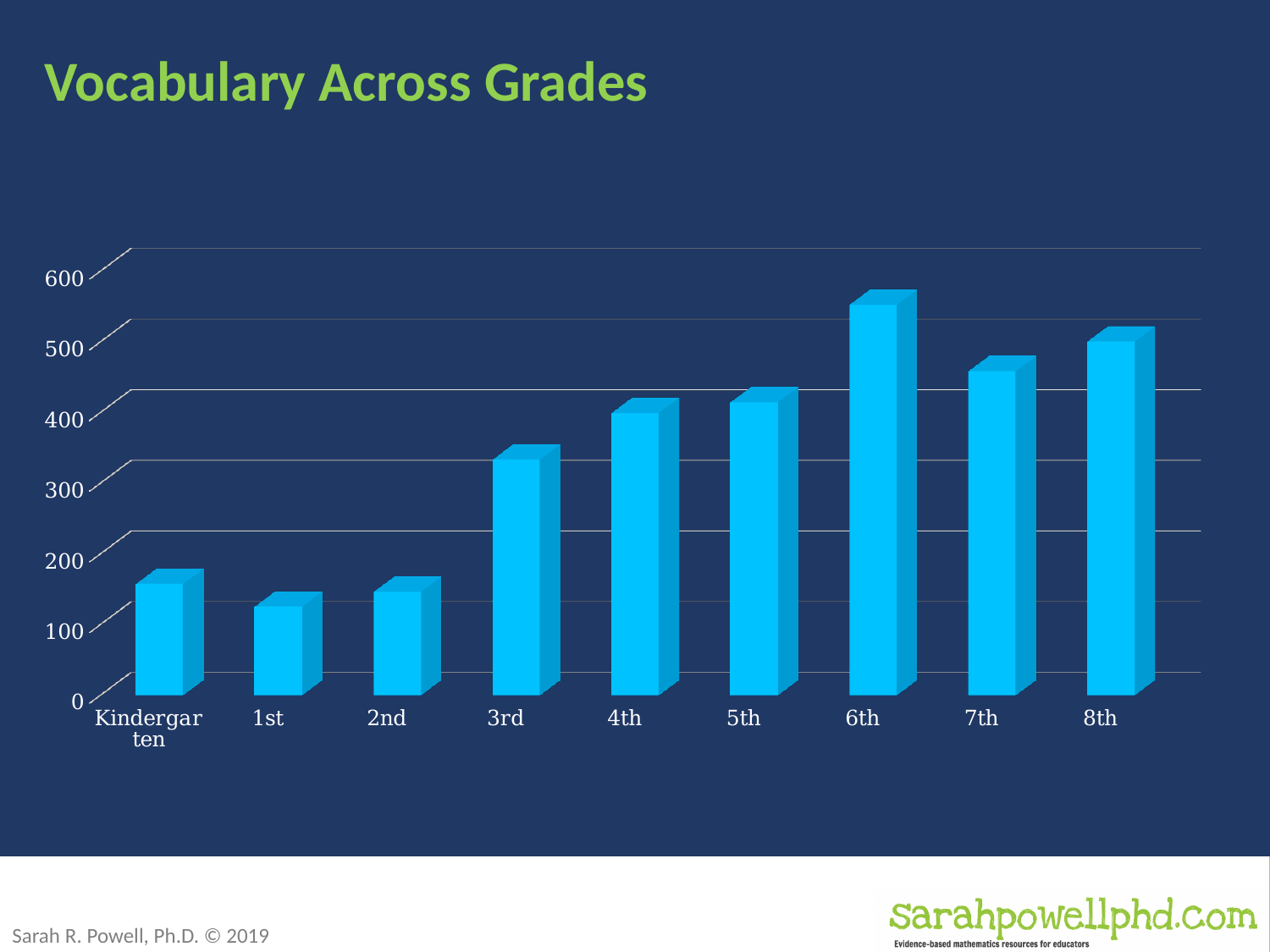
Is the value for 1st grade greater or less than 200? less How many grade categories are plotted on the chart? 9 Is the value for 3rd grade greater or less than 300? greater Which grade has the highest value on the chart? 6th Which grade has the lowest value on the chart? 1st Is the value for 7th grade greater or less than 500? less Which is larger, the value for 2nd grade or the value for 3rd grade? 3rd Which is larger, the value for 6th grade or the value for 8th grade? 6th What kind of chart is shown on the slide? bar chart What is the title of the chart? Vocabulary Across Grades